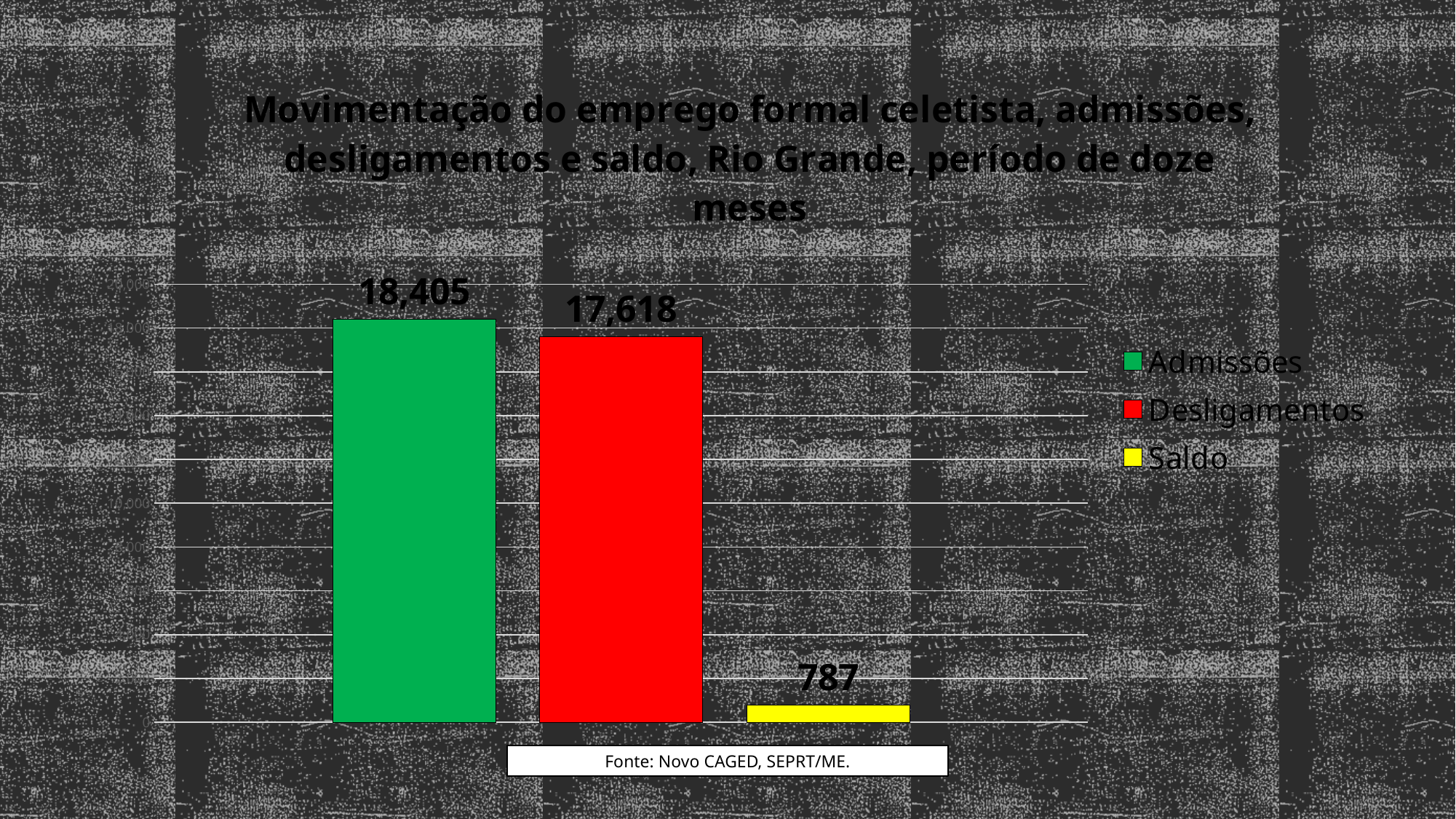
How many bars are plotted in the chart? 3 Which series has the lowest value? Saldo How many series does the legend list? 3 What is the value for Saldo? 787 What is the value for Desligamentos? 17,618 What kind of chart is shown on the slide? Bar chart Which series has the highest value? Admissões What colour is the bar for Saldo? Yellow What is the value for Admissões? 18,405 What is the difference between Admissões and Desligamentos? 787 Which is larger, Admissões or Desligamentos? Admissões What is the difference between Desligamentos and Saldo? 16,831